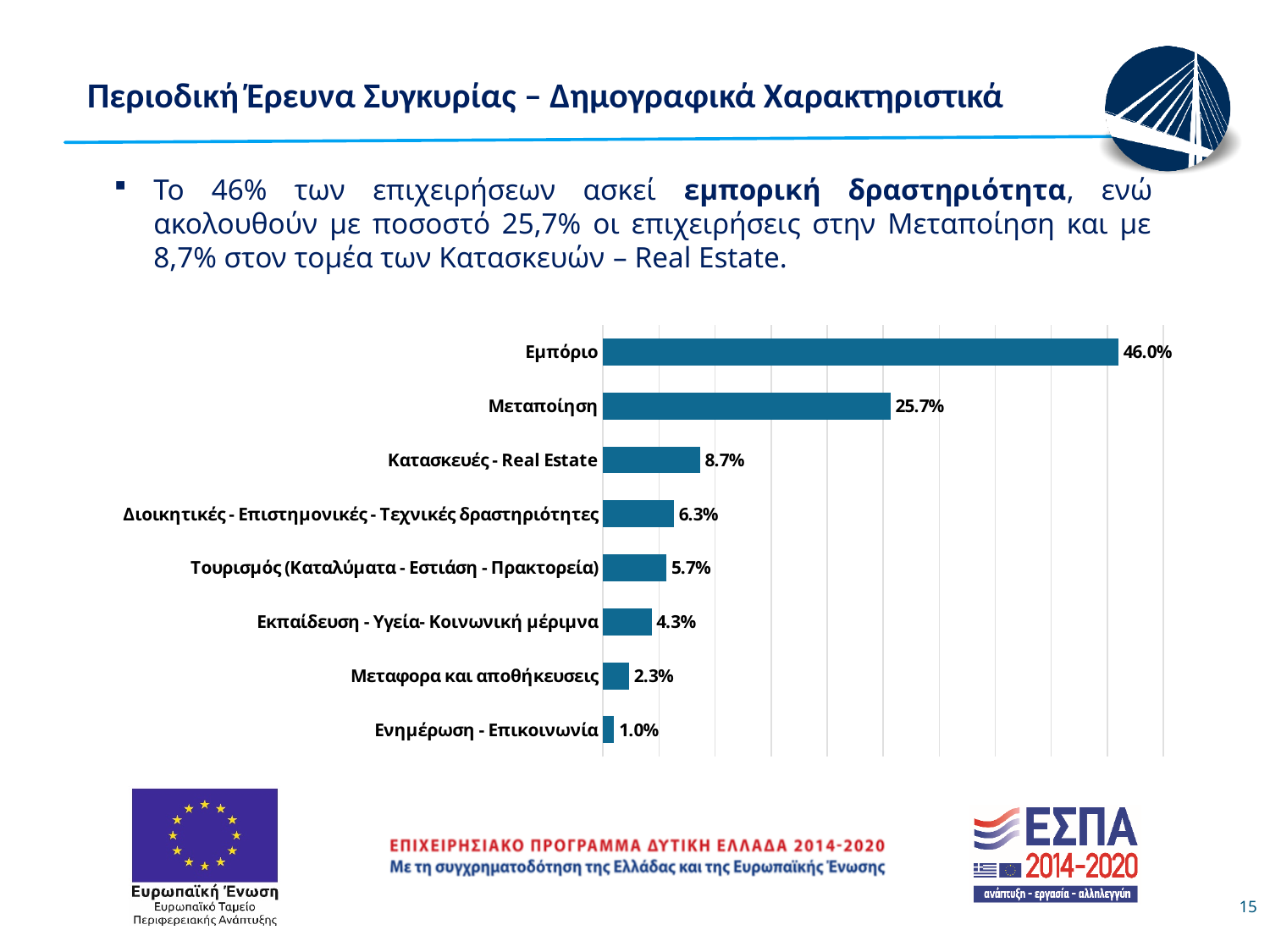
What is the value for Μεταποίηση? 25.7% What is the value for Εμπόριο? 46.0% What is the difference between the values for Μεταφορα και αποθήκευσεις and Ενημέρωση - Επικοινωνία? 1.3% What is the value for Κατασκευές - Real Estate? 8.7% Which is larger, the value for Διοικητικές - Επιστημονικές - Τεχνικές δραστηριότητες or the value for Εκπαίδευση - Υγεία- Κοινωνική μέριμνα? Διοικητικές - Επιστημονικές - Τεχνικές δραστηριότητες Which category has the highest value? Εμπόριο What kind of chart is shown on the slide? Bar chart What is the value for Ενημέρωση - Επικοινωνία? 1.0% What is the value for Τουρισμός (Καταλύματα - Εστίαση - Πρακτορεία)? 5.7% What is the difference between the values for Εμπόριο and Μεταποίηση? 20.3% How many categories are shown in the chart? 8 Which category has the lowest value? Ενημέρωση - Επικοινωνία